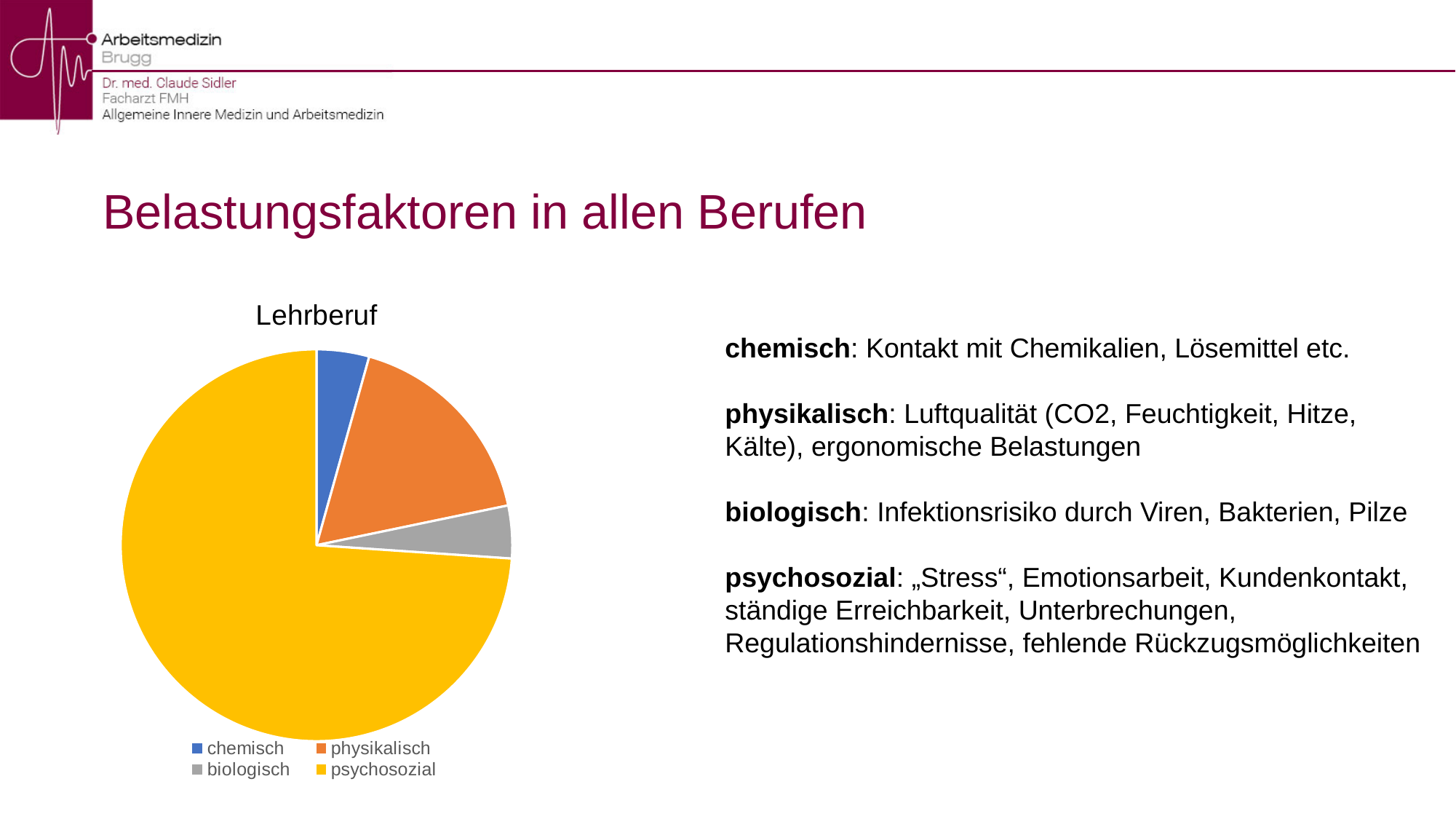
Which slice is larger, psychosozial or physikalisch? psychosozial What is the title of the pie chart? Lehrberuf Which category is shown in blue in the pie chart? chemisch Which slice is larger, physikalisch or biologisch? physikalisch What kind of chart is shown on the slide? pie chart Does the psychosozial slice make up more or less than half of the pie? more Which category has the largest slice in the pie chart? psychosozial Which slice is larger, physikalisch or chemisch? physikalisch How many slices does the pie chart have? 4 How many entries does the legend of the pie chart list? 4 What colour is the psychosozial slice in the pie chart? yellow